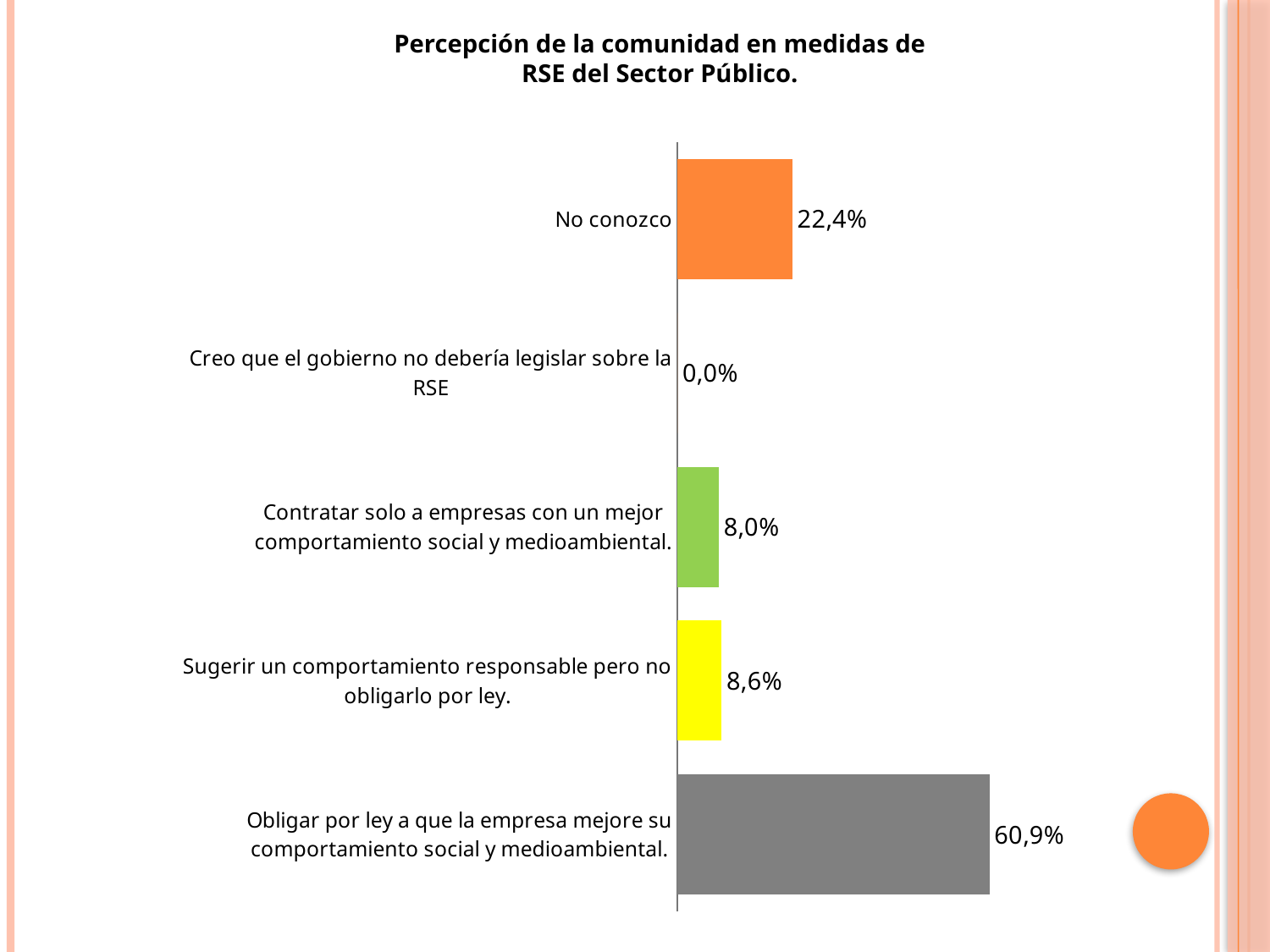
What kind of chart is shown on the slide? Bar chart What is the value for "Creo que el gobierno no debería legislar sobre la RSE"? 0,0% What is the value for "No conozco"? 22,4% What colour is the bar for "No conozco"? Orange What is the value for "Sugerir un comportamiento responsable pero no obligarlo por ley."? 8,6% What is the title of the chart? Percepción de la comunidad en medidas de RSE del Sector Público. What is the difference between the values for "Obligar por ley a que la empresa mejore su comportamiento social y medioambiental." and "No conozco"? 38,5% What is the value for "Obligar por ley a que la empresa mejore su comportamiento social y medioambiental."? 60,9% How many categories are shown in the chart? 5 Which category has the lowest value? Creo que el gobierno no debería legislar sobre la RSE Which category has the highest value? Obligar por ley a que la empresa mejore su comportamiento social y medioambiental. Which is larger: the value for "No conozco" or the value for "Contratar solo a empresas con un mejor comportamiento social y medioambiental."? No conozco